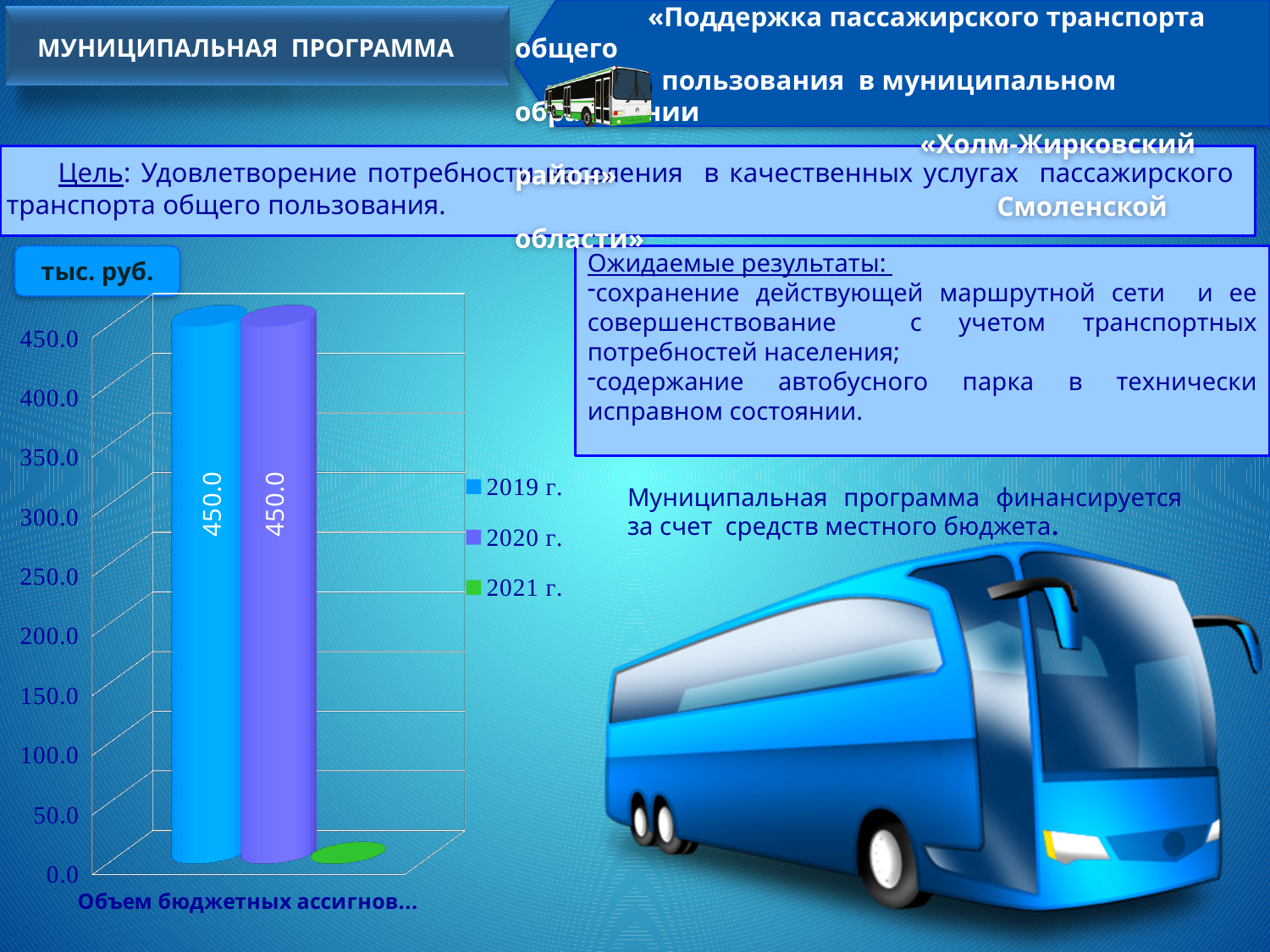
What is the value for 2020 г. on the chart? 450.0 What kind of chart is shown on the slide? bar chart What is the difference between the values for 2019 г. and 2020 г.? 0.0 How many series does the chart legend list? 3 How many categories are shown on the x axis of the chart? 1 What is the value for 2019 г. on the chart? 450.0 Which is larger, the value for 2019 г. or the value for 2020 г.? They are equal What unit is indicated in the label above the chart's vertical axis? тыс. руб. Which series has the lowest value on the chart? 2021 г. What colour represents 2021 г. in the chart legend? green Is the value for 2021 г. greater or less than 50.0? less